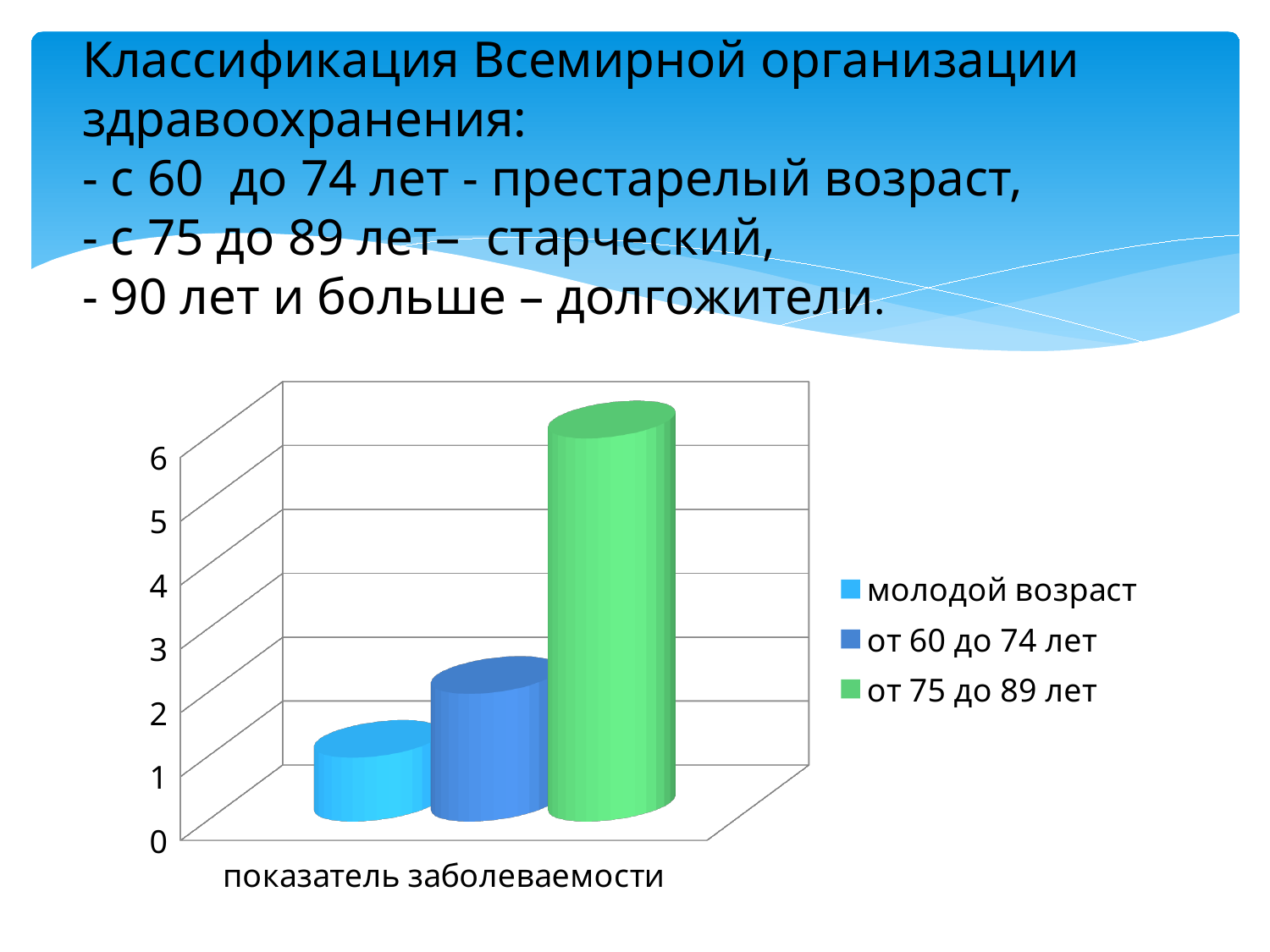
What kind of chart is shown on the slide? bar chart What is the category label shown under the bars? показатель заболеваемости Is the value for от 75 до 89 лет greater or less than 4? greater Is the value for от 60 до 74 лет greater or less than 4? less Which is larger: the value for от 60 до 74 лет or the value for молодой возраст? от 60 до 74 лет How many categories are shown on the x axis? 1 How many series does the legend list? 3 Which series is shown in green in the legend? от 75 до 89 лет Which series has the lowest value for показатель заболеваемости? молодой возраст Is the value for молодой возраст greater or less than 3? less Which is larger: the value for от 75 до 89 лет or the value for молодой возраст? от 75 до 89 лет Which series has the highest value for показатель заболеваемости? от 75 до 89 лет